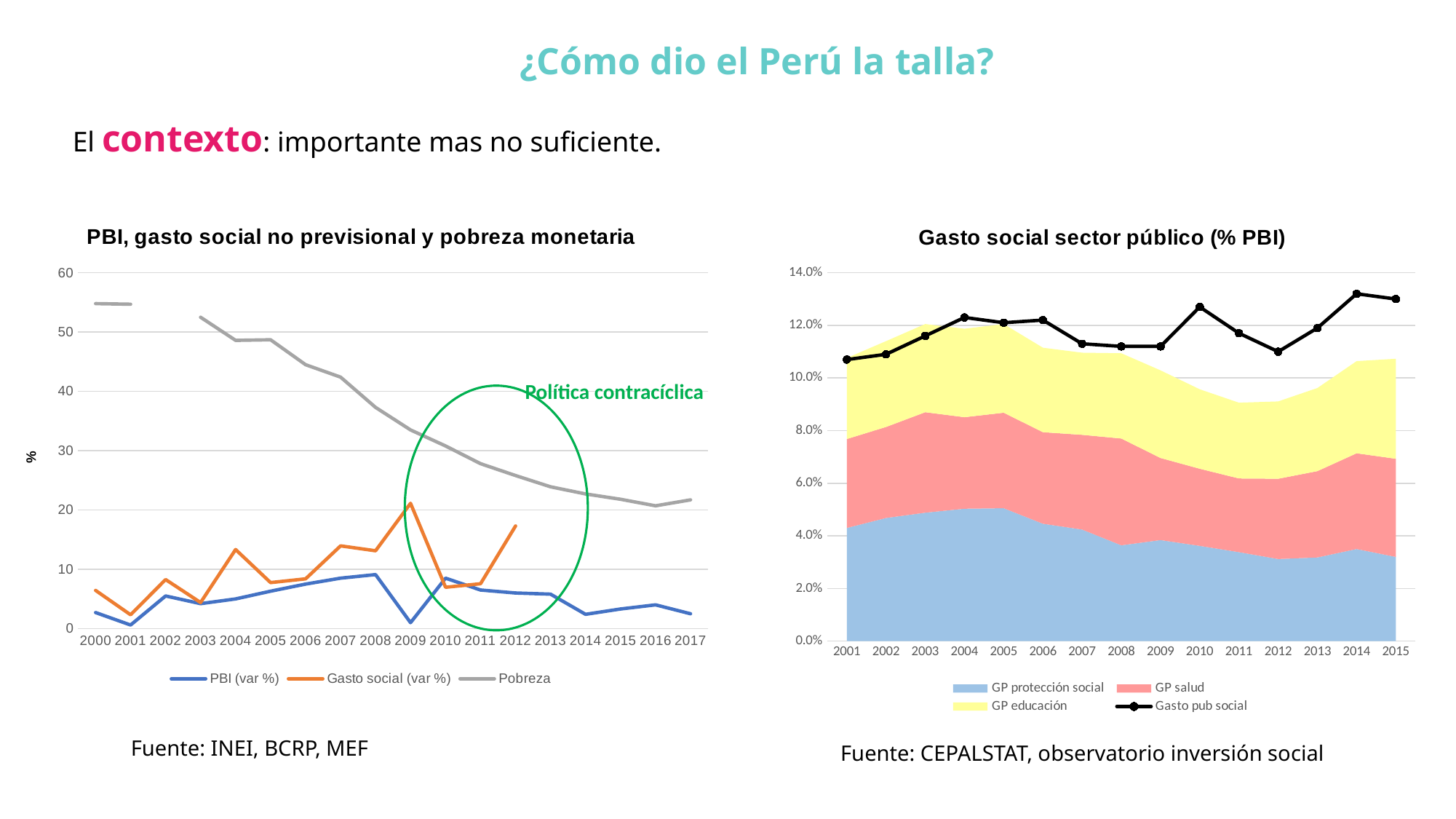
On the left chart 'PBI, gasto social no previsional y pobreza monetaria', is the Pobreza value for 2000 greater or less than 50? greater On the left chart 'PBI, gasto social no previsional y pobreza monetaria', does the Pobreza series rise or fall from 2000 to 2017? Fall On the left chart 'PBI, gasto social no previsional y pobreza monetaria', in which year does Gasto social (var %) reach its highest value? 2009 On the left chart 'PBI, gasto social no previsional y pobreza monetaria', how many series does the legend list? 3 On the left chart 'PBI, gasto social no previsional y pobreza monetaria', what kind of chart is it? Line chart On the right chart 'Gasto social sector público (% PBI)', which is larger for Gasto pub social: 2010 or 2012? 2010 On the left chart 'PBI, gasto social no previsional y pobreza monetaria', which is larger in 2009: PBI (var %) or Gasto social (var %)? Gasto social (var %) On the right chart 'Gasto social sector público (% PBI)', how many years are shown on the x axis? 15 On the left chart 'PBI, gasto social no previsional y pobreza monetaria', is the Gasto social (var %) value for 2009 greater or less than 10? greater On the right chart 'Gasto social sector público (% PBI)', is the Gasto pub social value for 2014 greater or less than 12.0%? greater On the right chart 'Gasto social sector público (% PBI)', how many entries does the legend list? 4 On the left chart 'PBI, gasto social no previsional y pobreza monetaria', how many years are shown on the x axis? 18